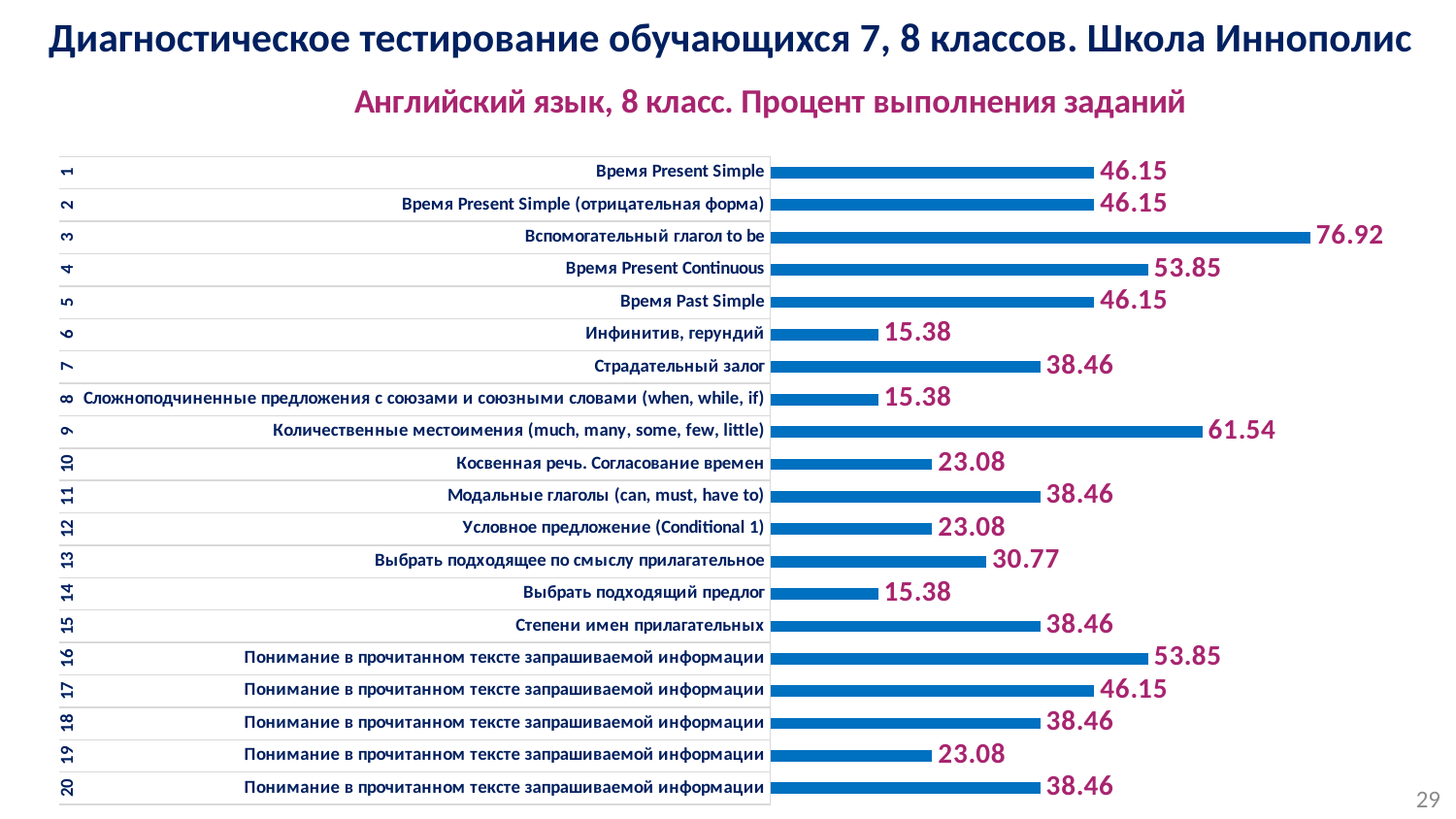
What is the value for "Выбрать подходящее по смыслу прилагательное" (task 13)? 30.77 Which is larger: the value for "Страдательный залог" (task 7) or "Косвенная речь. Согласование времен" (task 10)? Страдательный залог (task 7) What is the value for "Время Present Continuous" (task 4)? 53.85 What is the value for "Инфинитив, герундий" (task 6)? 15.38 Which task has the highest value? Вспомогательный глагол to be (task 3) What is the value for "Вспомогательный глагол to be" (task 3)? 76.92 What is the difference between the values for task 3 (Вспомогательный глагол to be) and task 9 (Количественные местоимения)? 15.38 What is the value for "Количественные местоимения (much, many, some, few, little)" (task 9)? 61.54 What is the value for task 19? 23.08 What is the lowest value shown on the chart? 15.38 How many tasks (categories) are shown on the chart? 20 What type of chart is shown on the slide? Bar chart